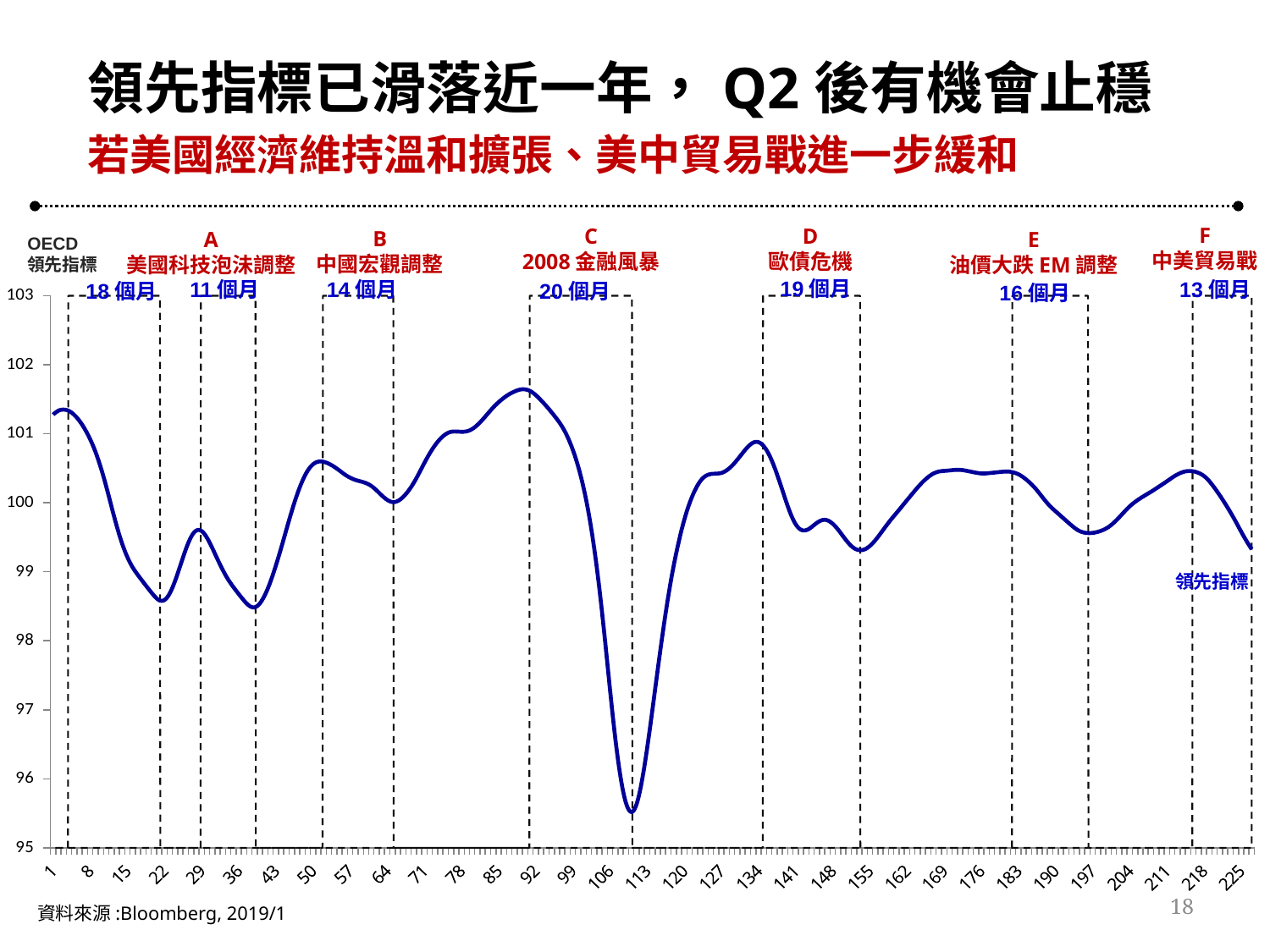
How many months are marked for the 中美貿易戰 (F) decline period? 13 個月 Is the value of the line at its lowest point (around x = 113) greater or less than 96? less What is the data source cited below the chart? Bloomberg, 2019/1 Is the value of the line at the last point (around x = 225) greater or less than 100? less How many months are marked for the 2008 金融風暴 (C) decline period? 20 個月 Which labelled decline period has the longest duration in months? C 2008 金融風暴 (20 個月) Is the value of the line at its peak near x = 92 greater or less than 101? greater Which labelled episode (A–F) corresponds to the lowest point of the line? C (2008 金融風暴) What is the name of the plotted series, as labelled on the chart? 領先指標 Does the line rise or fall between x = 218 and x = 225? fall How many data series are plotted on the chart? 1 What kind of chart is shown on the slide? line chart